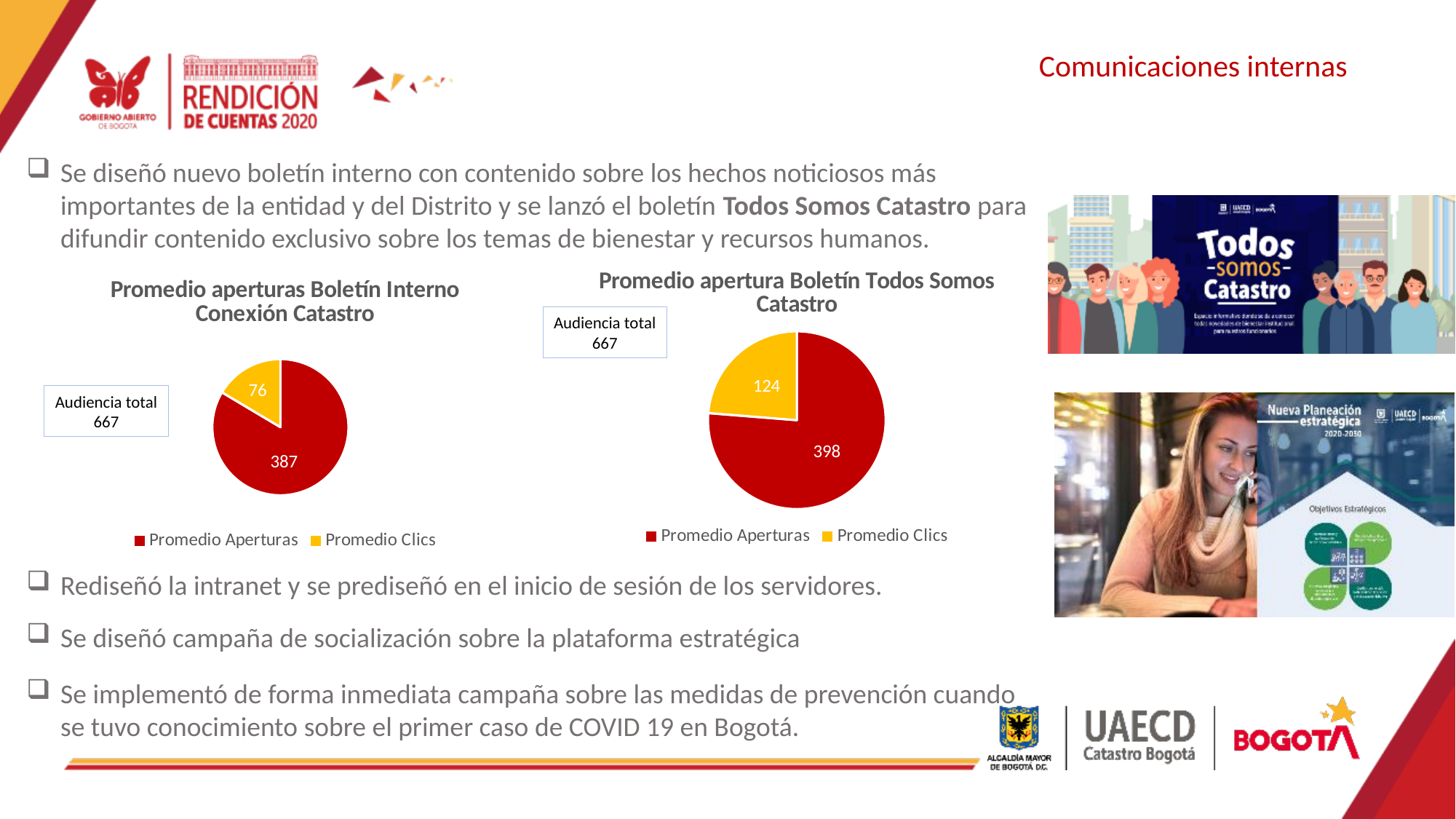
In the chart titled 'Promedio aperturas Boletín Interno Conexión Catastro', what is the value for Promedio Aperturas? 387 In the chart titled 'Promedio aperturas Boletín Interno Conexión Catastro', which slice is the largest? Promedio Aperturas In the chart titled 'Promedio apertura Boletín Todos Somos Catastro', what is the value for Promedio Aperturas? 398 In the chart titled 'Promedio apertura Boletín Todos Somos Catastro', what is the difference between Promedio Aperturas and Promedio Clics? 274 What type of chart is 'Promedio apertura Boletín Todos Somos Catastro'? Pie chart In the chart titled 'Promedio apertura Boletín Todos Somos Catastro', what is the value for Promedio Clics? 124 In the chart titled 'Promedio aperturas Boletín Interno Conexión Catastro', what is the difference between Promedio Aperturas and Promedio Clics? 311 How many series does the legend of the chart titled 'Promedio aperturas Boletín Interno Conexión Catastro' list? 2 Which chart has the larger Promedio Clics value, 'Promedio aperturas Boletín Interno Conexión Catastro' or 'Promedio apertura Boletín Todos Somos Catastro'? Promedio apertura Boletín Todos Somos Catastro In the chart titled 'Promedio apertura Boletín Todos Somos Catastro', which slice is the smallest? Promedio Clics In the chart titled 'Promedio aperturas Boletín Interno Conexión Catastro', what colour is the Promedio Clics slice? Yellow In the chart titled 'Promedio aperturas Boletín Interno Conexión Catastro', what is the value for Promedio Clics? 76